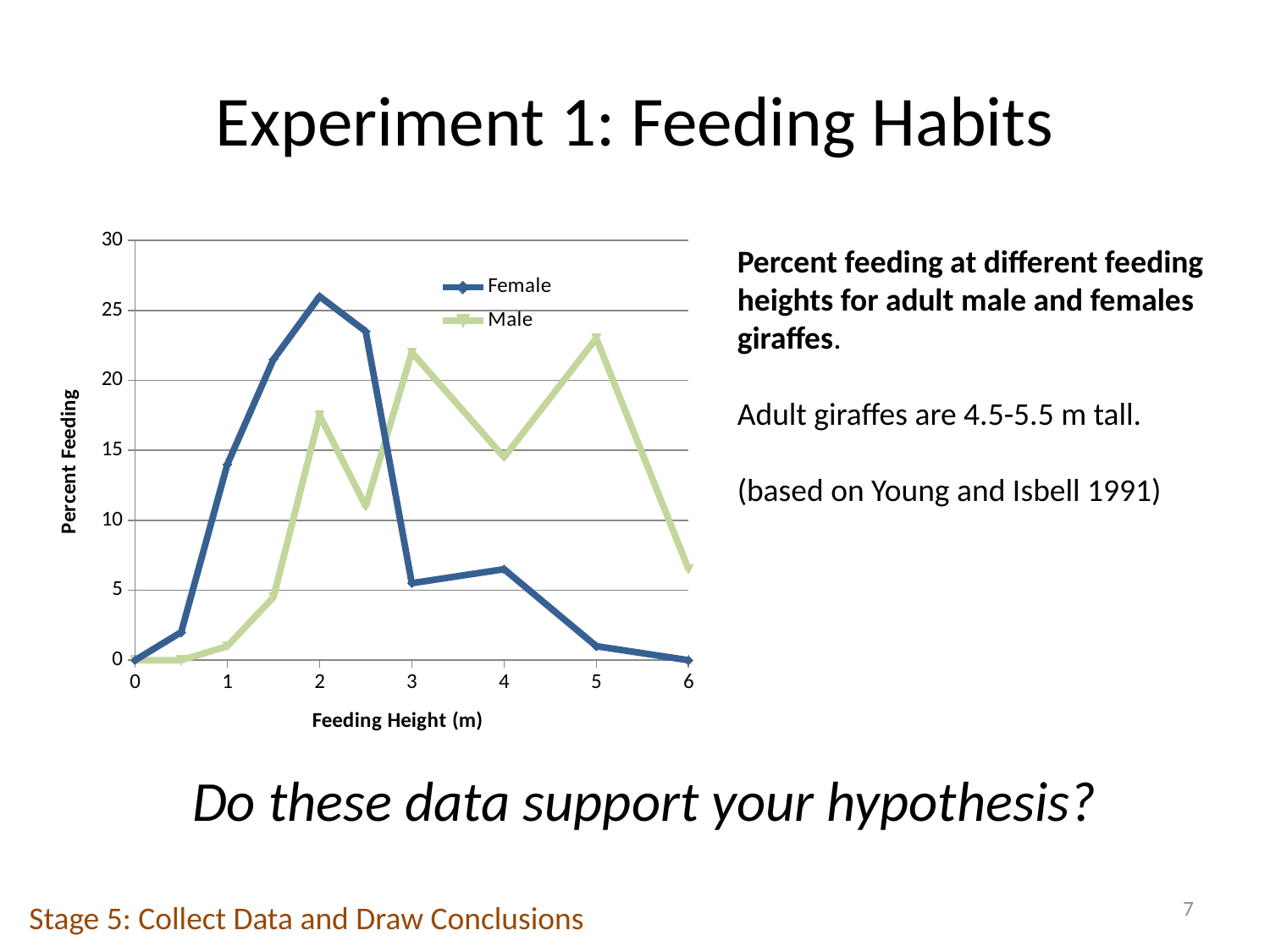
At a feeding height of 5 m, which series has the higher percent feeding, Female or Male? Male Which two series are listed in the chart legend? Female and Male Is the Female value at a feeding height of 3 m greater or less than 10? less At a feeding height of 2 m, which series has the higher percent feeding, Female or Male? Female What kind of chart is shown on the slide? line chart What is the label of the chart's x axis? Feeding Height (m) Is the Female value at a feeding height of 2 m greater or less than 25? greater Does the Female series rise or fall as feeding height increases from 2 m to 6 m? fall Is the Male value at a feeding height of 6 m greater or less than 10? less At which feeding height does the Female series reach its highest percent feeding? 2 How many series does the chart legend list? 2